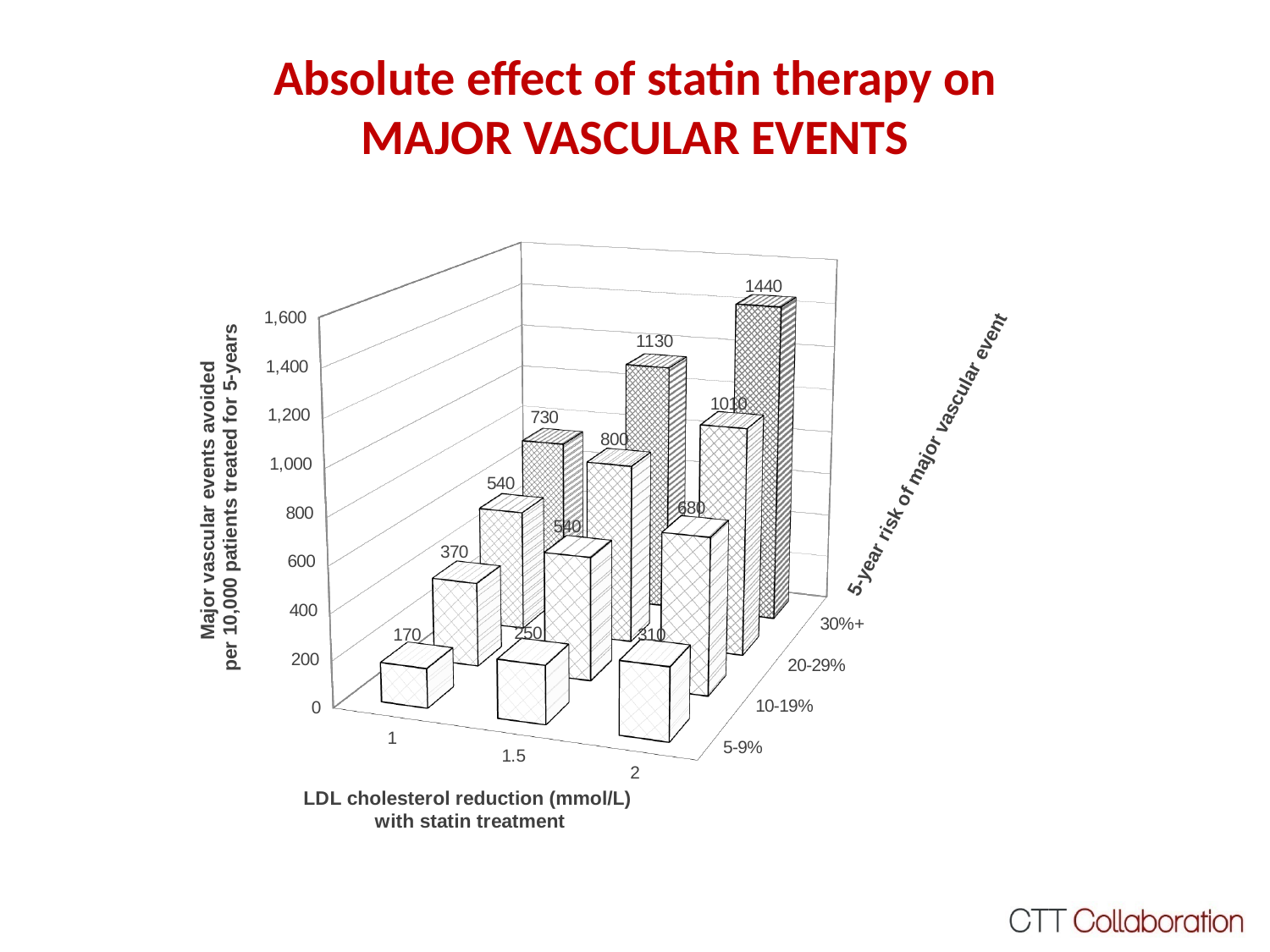
What is the value for an LDL cholesterol reduction of 2 mmol/L in the 30%+ risk group? 1440 Which is larger: the value for 1.5 mmol/L in the 30%+ group or the value for 2 mmol/L in the 20-29% group? 1.5 mmol/L in the 30%+ group What is the value for an LDL cholesterol reduction of 1 mmol/L in the 30%+ risk group? 730 What kind of chart is shown on the slide? Bar chart Which combination of LDL cholesterol reduction and risk group has the highest number of major vascular events avoided? 2 mmol/L, 30%+ Which combination of LDL cholesterol reduction and risk group has the lowest number of major vascular events avoided? 1 mmol/L, 5-9% In the 30%+ risk group, what is the difference between the values for 2 mmol/L and 1 mmol/L LDL reduction? 710 What is the value for an LDL cholesterol reduction of 1 mmol/L in the 5-9% risk group? 170 For an LDL reduction of 1 mmol/L, what is the difference between the 30%+ and 5-9% risk groups? 560 What is the value for an LDL cholesterol reduction of 1.5 mmol/L in the 30%+ risk group? 1130 Within the 30%+ risk group, do the values rise or fall as LDL cholesterol reduction increases from 1 to 2 mmol/L? Rise How many 5-year risk categories are shown on the chart? 4